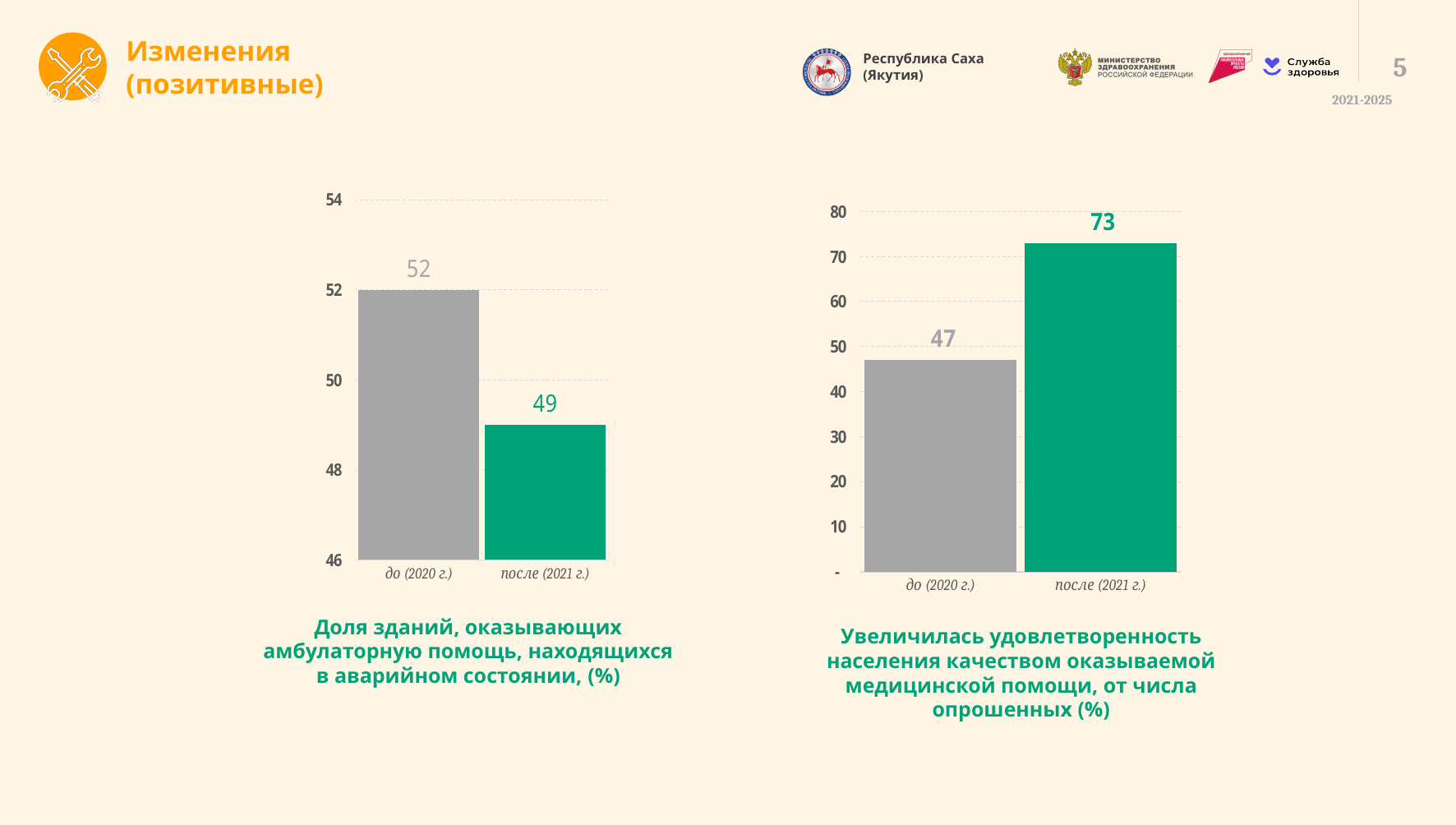
In the right chart (population satisfaction with quality of medical care), is the value for 'после (2021 г.)' greater or less than 70? greater In the left chart (share of buildings providing outpatient care in emergency condition), what is the value for 'до (2020 г.)'? 52 How many bars does the right chart (population satisfaction with quality of medical care) have? 2 In the left chart (share of buildings providing outpatient care in emergency condition), what is the value for 'после (2021 г.)'? 49 In the right chart (population satisfaction with quality of medical care), which category has the higher value? после (2021 г.) In the left chart (share of buildings in emergency condition), which category has the lower value? после (2021 г.) In the right chart (population satisfaction with quality of medical care), what is the value for 'до (2020 г.)'? 47 In the left chart (share of buildings in emergency condition), do the values rise or fall from 'до (2020 г.)' to 'после (2021 г.)'? fall In the left chart (share of buildings in emergency condition), what is the difference between the 'до (2020 г.)' and 'после (2021 г.)' values? 3 What type of chart is the left chart (share of buildings in emergency condition)? bar chart In the right chart (population satisfaction with quality of medical care), what is the value for 'после (2021 г.)'? 73 In the right chart (population satisfaction with quality of medical care), by how much did the value increase from 'до (2020 г.)' to 'после (2021 г.)'? 26